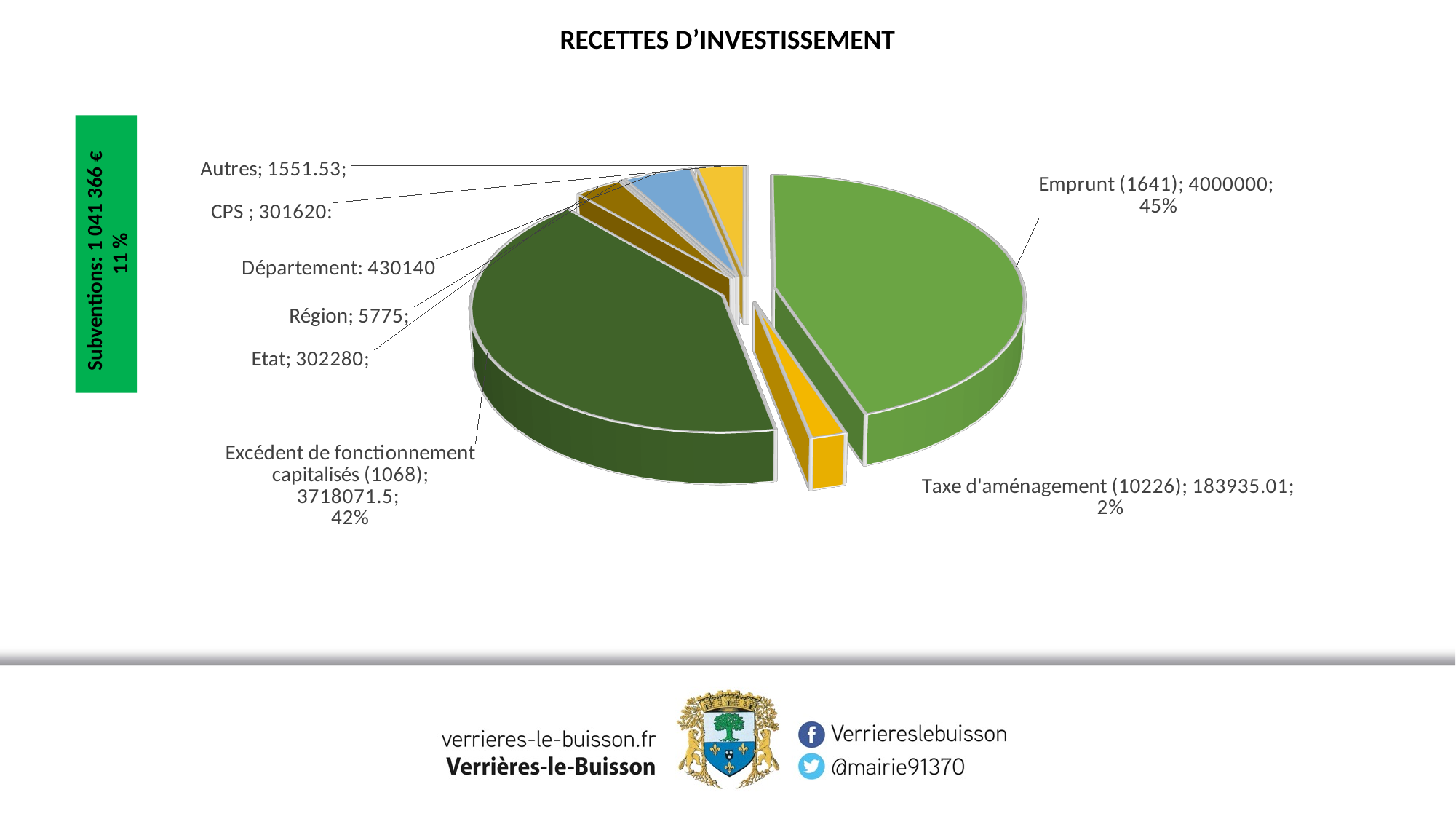
What is the title of the chart? RECETTES D'INVESTISSEMENT What share of the pie does Emprunt (1641) represent? 45% What is the value shown for Département? 430140 What is the value shown for Excédent de fonctionnement capitalisés (1068)? 3718071.5 Which slice has the largest value? Emprunt (1641) What share of the pie does Excédent de fonctionnement capitalisés (1068) represent? 42% What is the value shown for Emprunt (1641)? 4000000 What is the value shown for Taxe d'aménagement (10226)? 183935.01 Which slice has the smallest value? Autres Which is larger, the value for Département or the value for Etat? Département What kind of chart is shown on the slide? pie chart What is the difference between the value for Emprunt (1641) and the value for Excédent de fonctionnement capitalisés (1068)? 281928.5